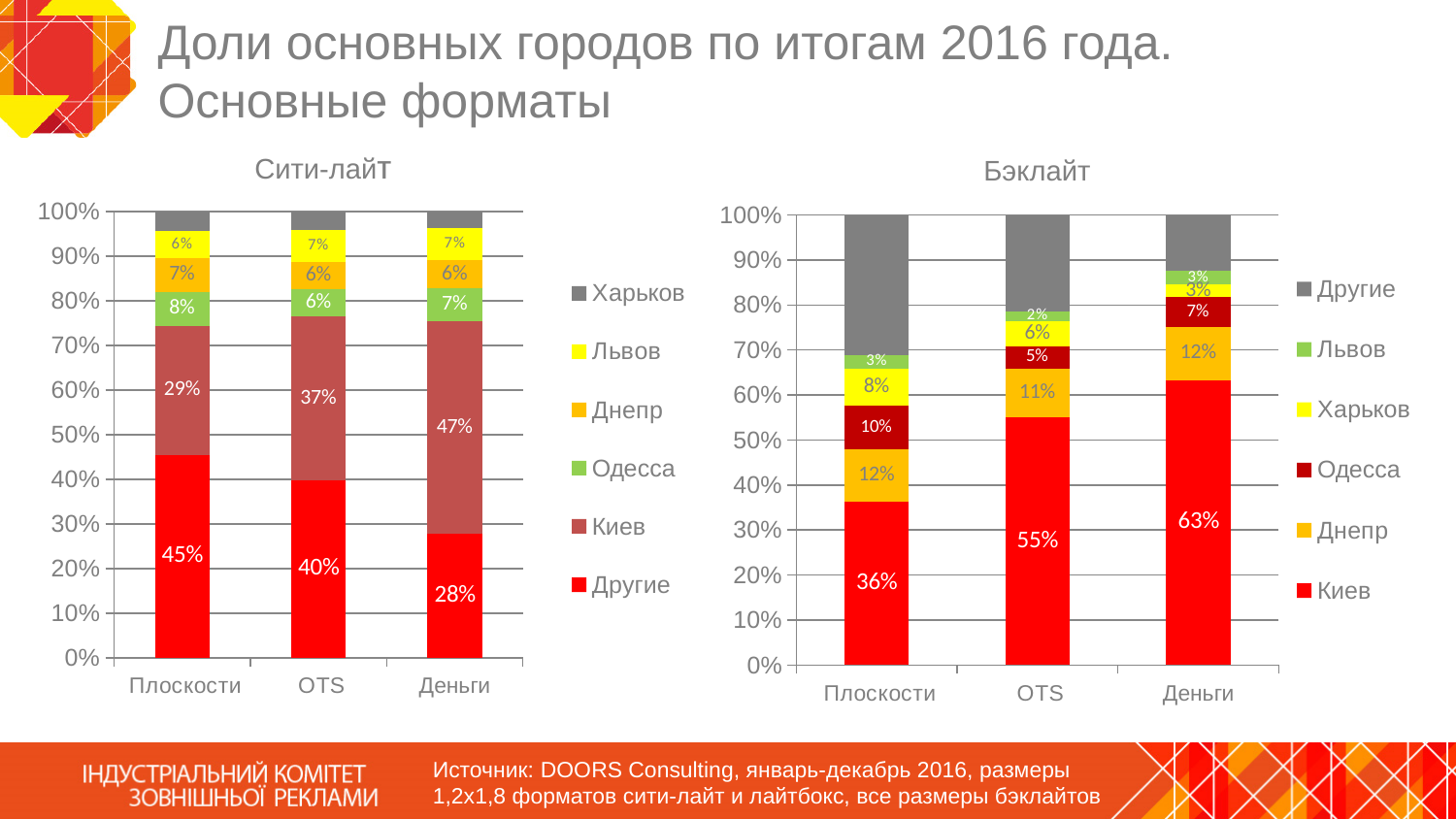
In the Бэклайт chart, which category has the lowest value for Одесса? OTS How many series does the legend of the Сити-лайт chart list? 6 In the Бэклайт chart, what is the value for Днепр in the Плоскости bar? 12% How many categories are shown on the x axis of the Бэклайт chart? 3 In the Бэклайт chart, what is the difference between the Киев values for OTS and Плоскости? 19% What kind of chart is the Сити-лайт chart? Stacked bar chart In the Сити-лайт chart, what is the value for Одесса in the Плоскости bar? 8% In the Бэклайт chart, which category has the highest value for Киев? Деньги In the Бэклайт chart, does the Киев value rise or fall from Плоскости to Деньги? Rise In the Сити-лайт chart, what is the value for Киев in the Деньги bar? 47% In the Сити-лайт chart, is the Другие value larger for Плоскости or for Деньги? Плоскости In the Бэклайт chart, what is the value for Киев in the Деньги bar? 63%